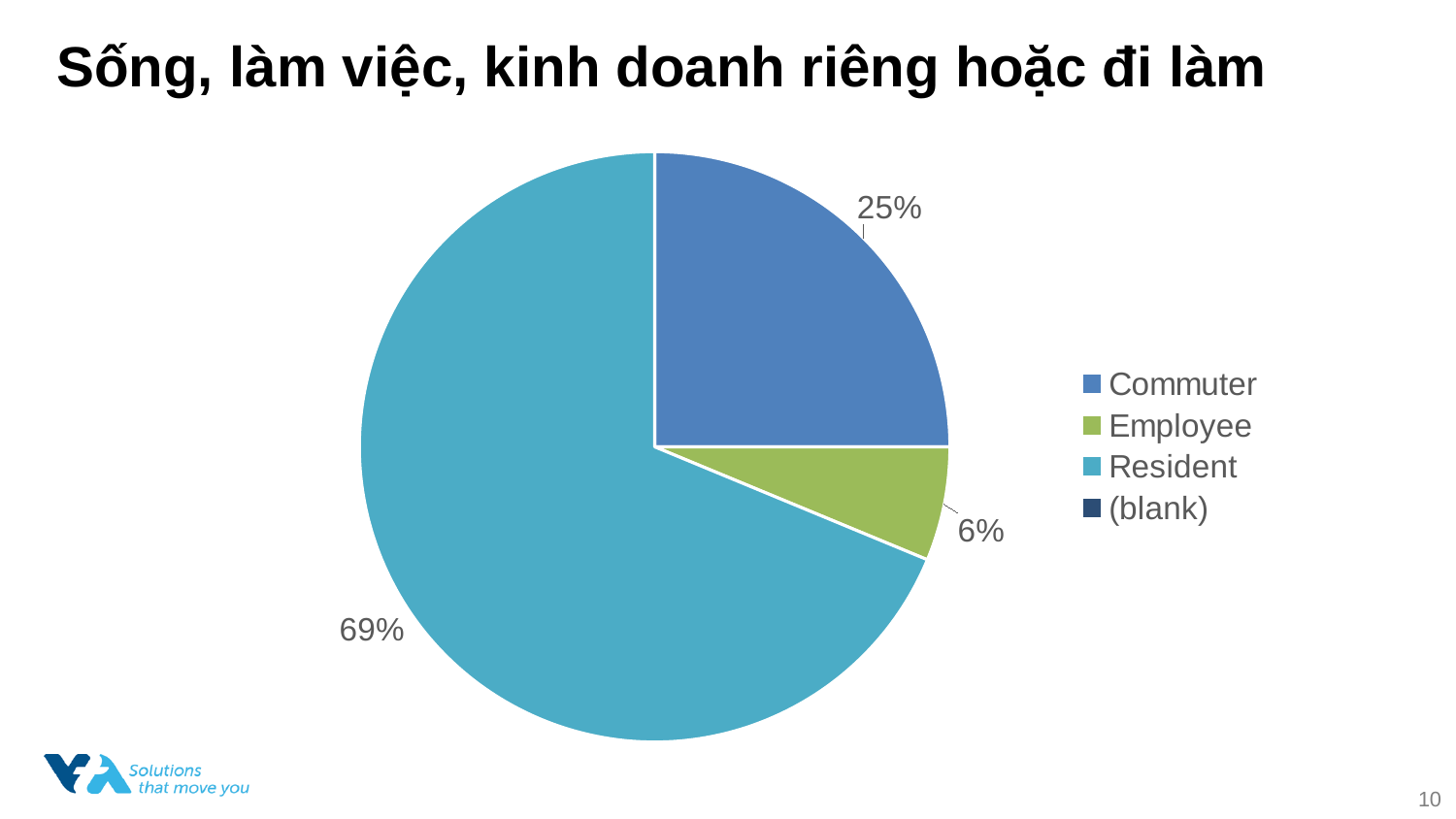
What share of the pie does Commuter have? 25% What share of the pie does Employee have? 6% Which labelled slice is the smallest in the pie? Employee What is the difference in percentage points between the Resident and Commuter slices? 44 What colour is the Resident slice in the pie chart? teal blue What is the title of the slide containing the pie chart? Sống, làm việc, kinh doanh riêng hoặc đi làm Which category has the largest slice of the pie? Resident What is the difference in percentage points between the Commuter and Employee slices? 19 How many entries does the legend list? 4 What kind of chart is shown on the slide? pie chart Which is larger, the Commuter slice or the Employee slice? Commuter What share of the pie does Resident have? 69%